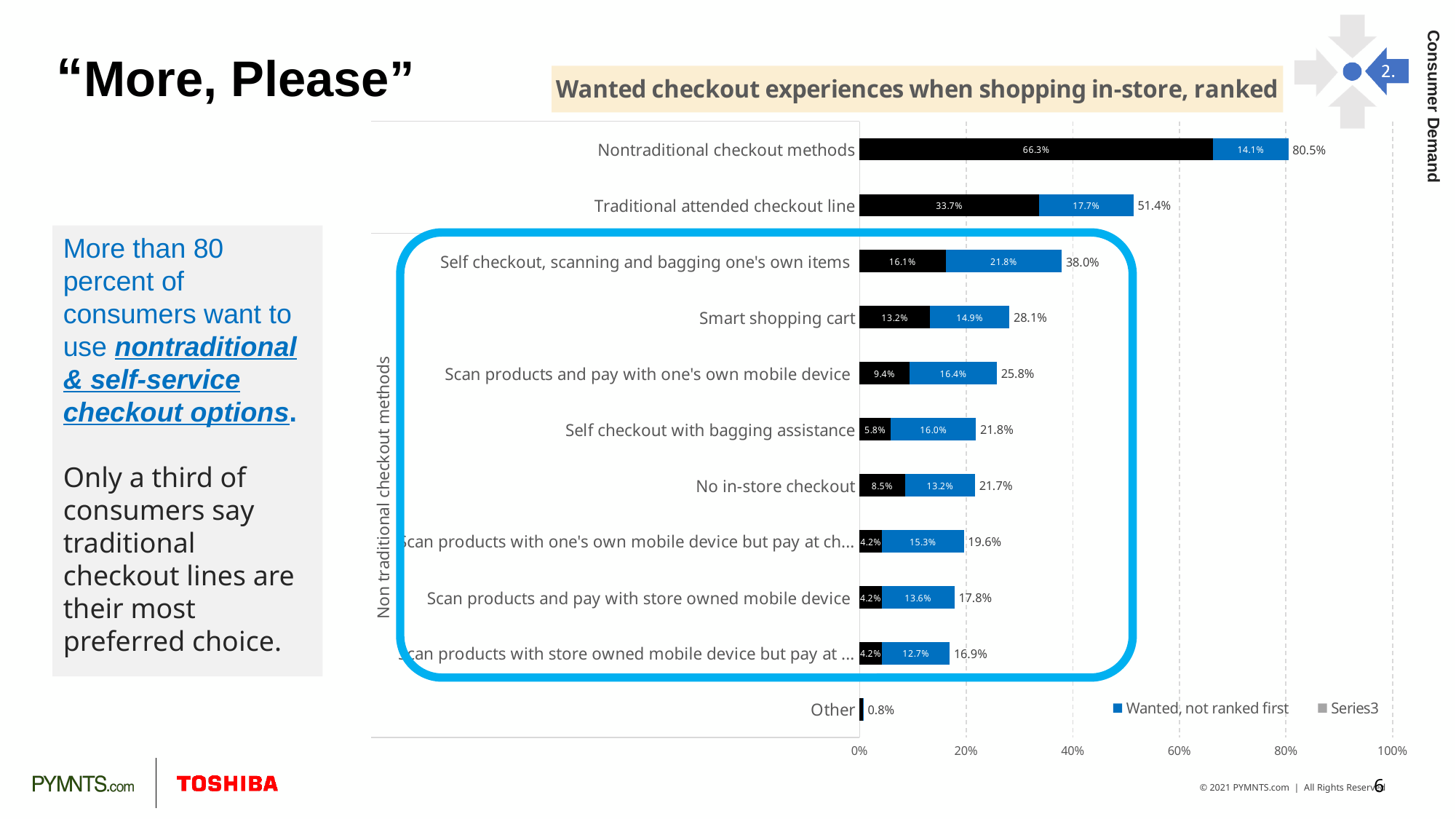
What is the 'Wanted, not ranked first' (blue) value for Smart shopping cart? 14.9% What is the title of the chart? Wanted checkout experiences when shopping in-store, ranked What is the black segment value for Self checkout, scanning and bagging one's own items? 16.1% What is the total value shown for Traditional attended checkout line? 51.4% How many categories are plotted on the chart? 11 What is the difference between the total values for Nontraditional checkout methods and Traditional attended checkout line? 29.1% Which category has the lowest total value? Other Is the total value for Self checkout, scanning and bagging one's own items greater or less than 40%? less Which category has the highest total value? Nontraditional checkout methods What kind of chart is shown on the slide? Stacked bar chart What is the total value shown for Nontraditional checkout methods? 80.5% Which has a larger total value, Smart shopping cart or Scan products and pay with one's own mobile device? Smart shopping cart